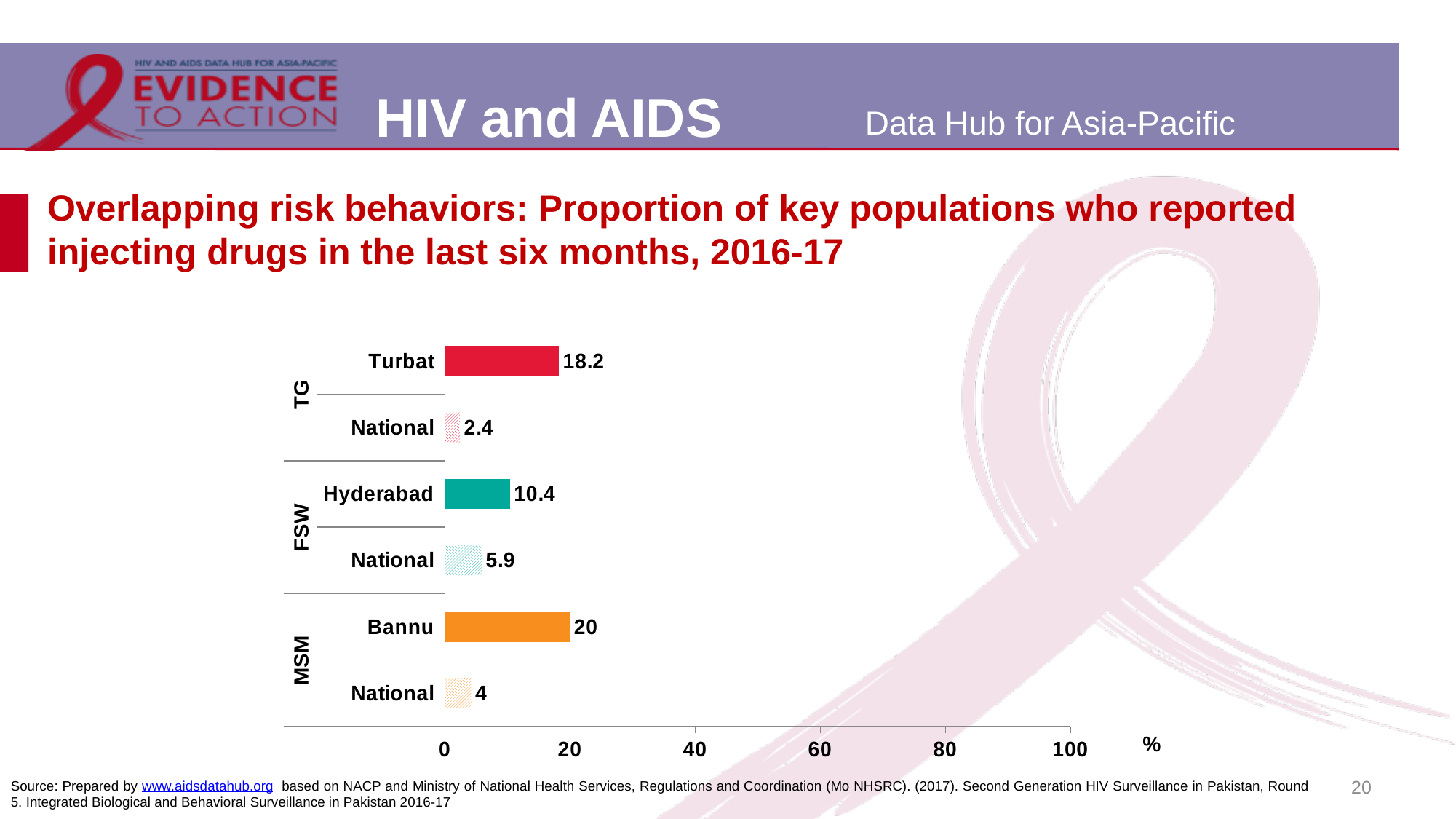
What is the value for Turbat in the TG group? 18.2 What unit is shown at the end of the x axis? % What is the value for Bannu in the MSM group? 20 Which bar has the highest value on the chart? Bannu (MSM) Which is larger, the value for Hyderabad or the value for Turbat? Turbat What is the National value for FSW? 5.9 How many bars are plotted on the chart? 6 What is the difference between the Turbat value and the TG National value? 15.8 Which bar has the lowest value on the chart? National (TG) What kind of chart is shown on the slide? Bar chart What is the value for Hyderabad in the FSW group? 10.4 What is the difference between the Bannu value and the MSM National value? 16